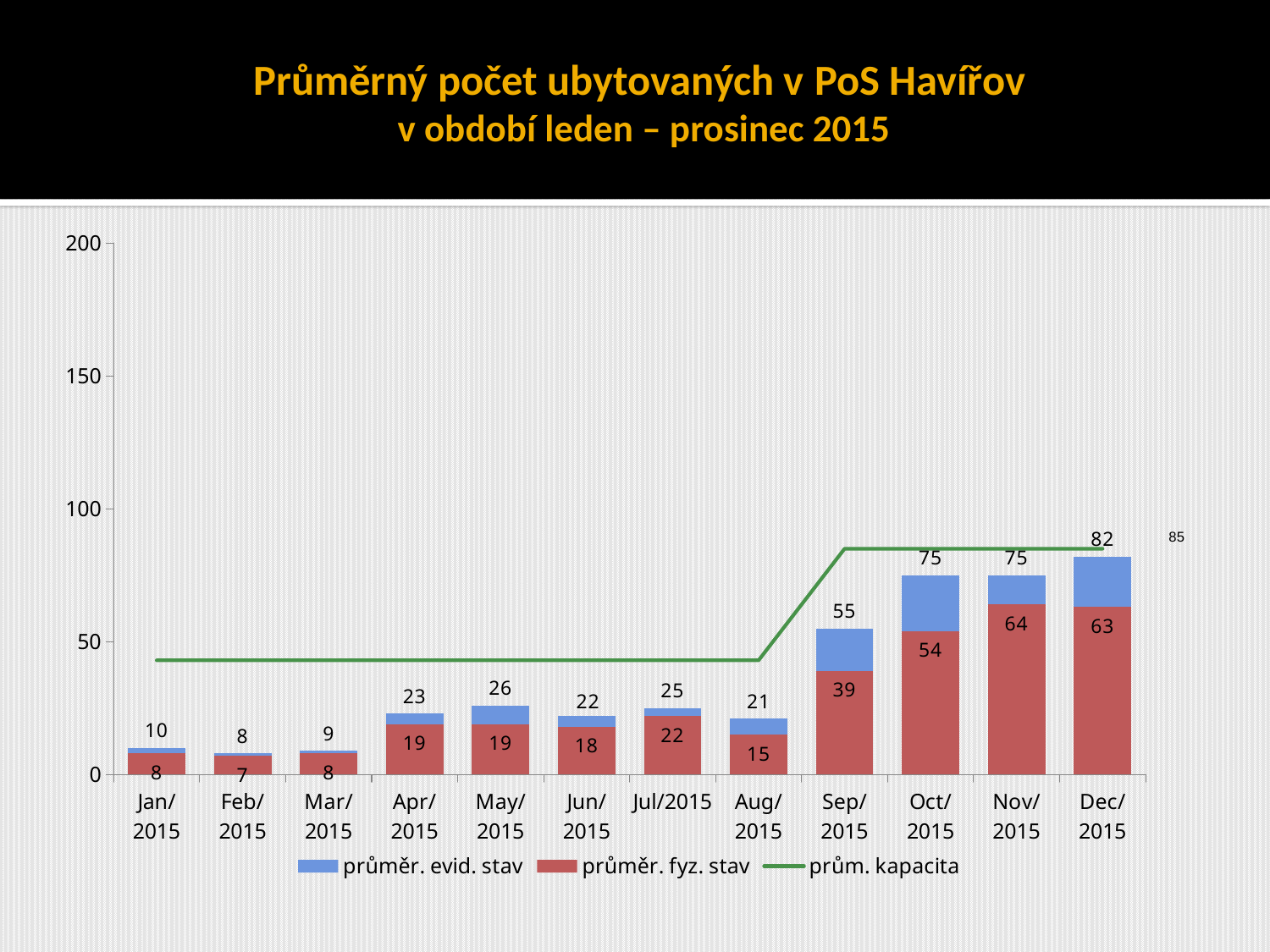
Is the prům. kapacita line in Jan/2015 greater or less than 50? less What is the difference between průměr. evid. stav and průměr. fyz. stav in Nov/2015? 11 Which month has the highest value of průměr. evid. stav? Dec/2015 Which month has the lowest value of průměr. fyz. stav? Feb/2015 What kind of chart is this? bar chart with a line What is the value of průměr. fyz. stav for Sep/2015? 39 Does průměr. evid. stav rise or fall from Aug/2015 to Dec/2015? rise Which is larger, průměr. fyz. stav in Nov/2015 or in Dec/2015? Nov/2015 How many months are shown on the x axis? 12 How many series does the legend list? 3 What is the value of průměr. fyz. stav for Oct/2015? 54 What is the value of průměr. evid. stav for Dec/2015? 82